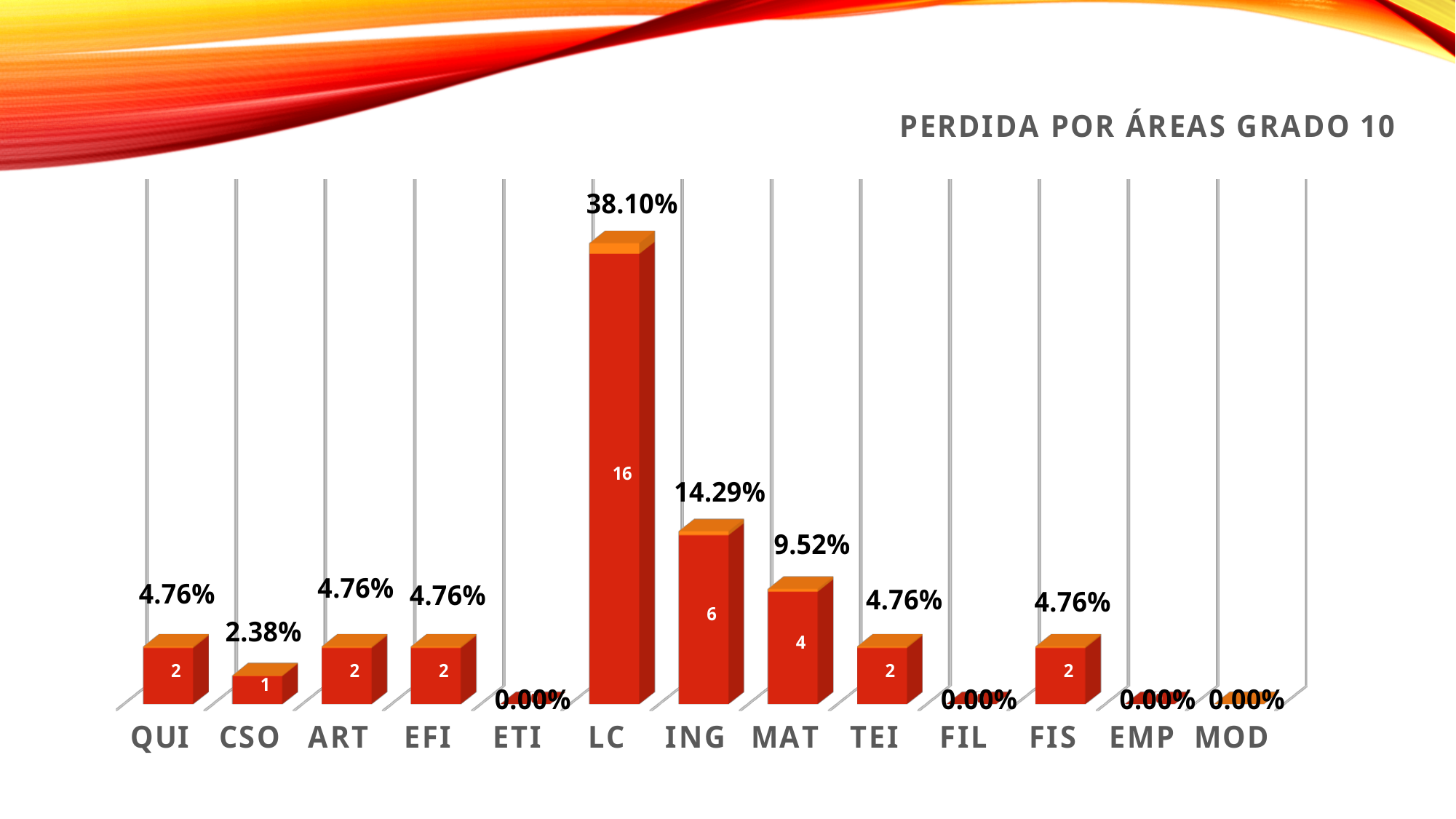
What is the title of the chart? PERDIDA POR ÁREAS GRADO 10 What percentage is shown for CSO? 2.38% Which is larger, the percentage for MAT or the percentage for TEI? MAT How many areas are shown on the x axis? 13 What is the difference in percentage between LC and ING? 23.81% What type of chart is this? Bar chart What number is printed inside the LC bar? 16 What percentage is shown for ING? 14.29% What percentage is shown for LC? 38.10% What number is printed inside the MAT bar? 4 What is the difference between the counts shown for ING and MAT? 2 Which area has the highest percentage? LC